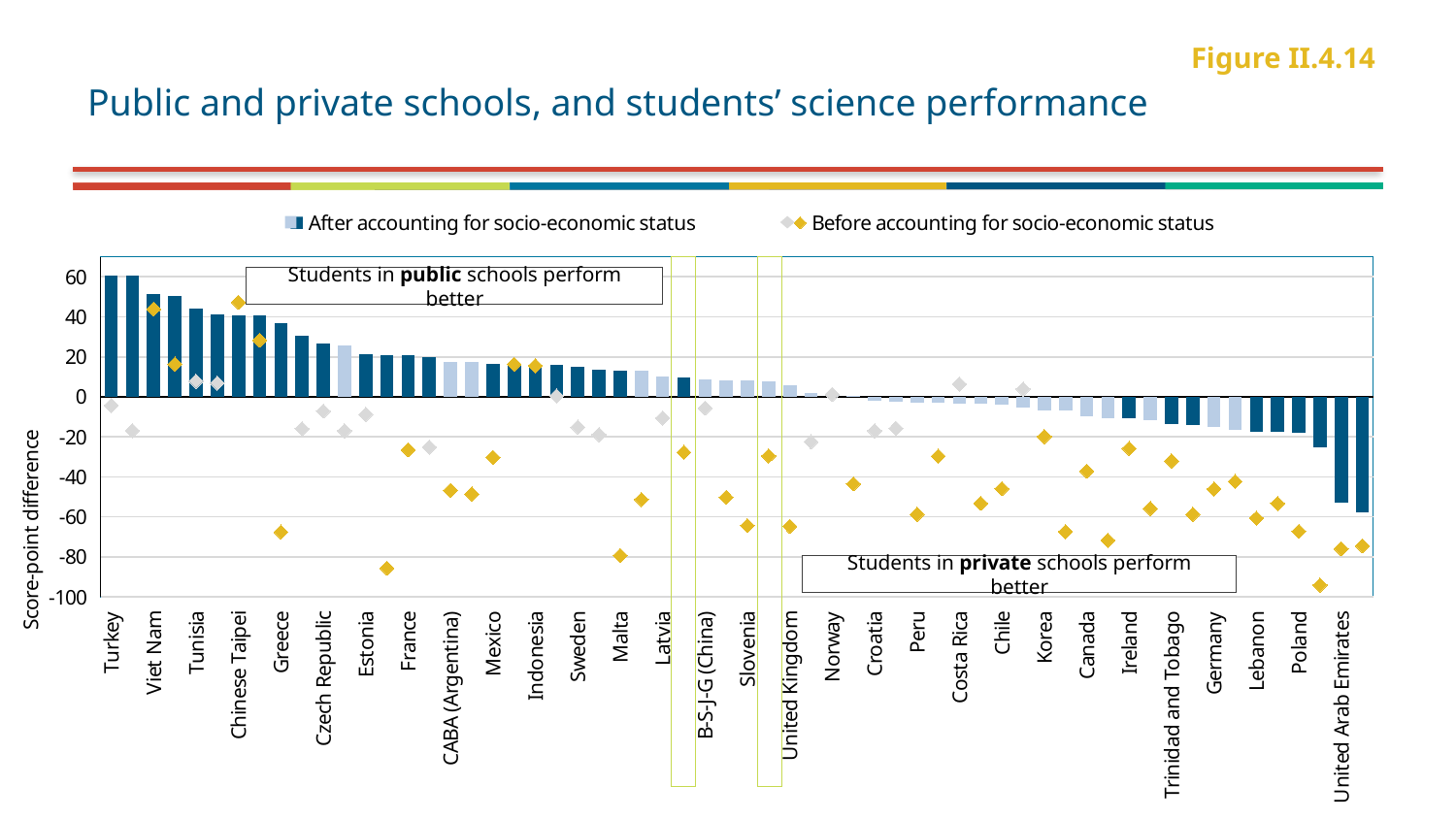
What is the title of the chart? Public and private schools, and students' science performance How many series does the legend list? 2 Is the bar for United Arab Emirates (after accounting for socio-economic status) greater or less than -40? less Do the bars for 'After accounting for socio-economic status' rise or fall from left to right across the countries? fall Is the 'Before accounting for socio-economic status' value for Greece greater or less than -60? less Which has the larger bar after accounting for socio-economic status, Turkey or Viet Nam? Turkey Is the bar for Czech Republic (after accounting for socio-economic status) greater or less than 20? greater What is the label of the vertical axis? Score-point difference What kind of chart is shown on the slide? combination bar and line chart